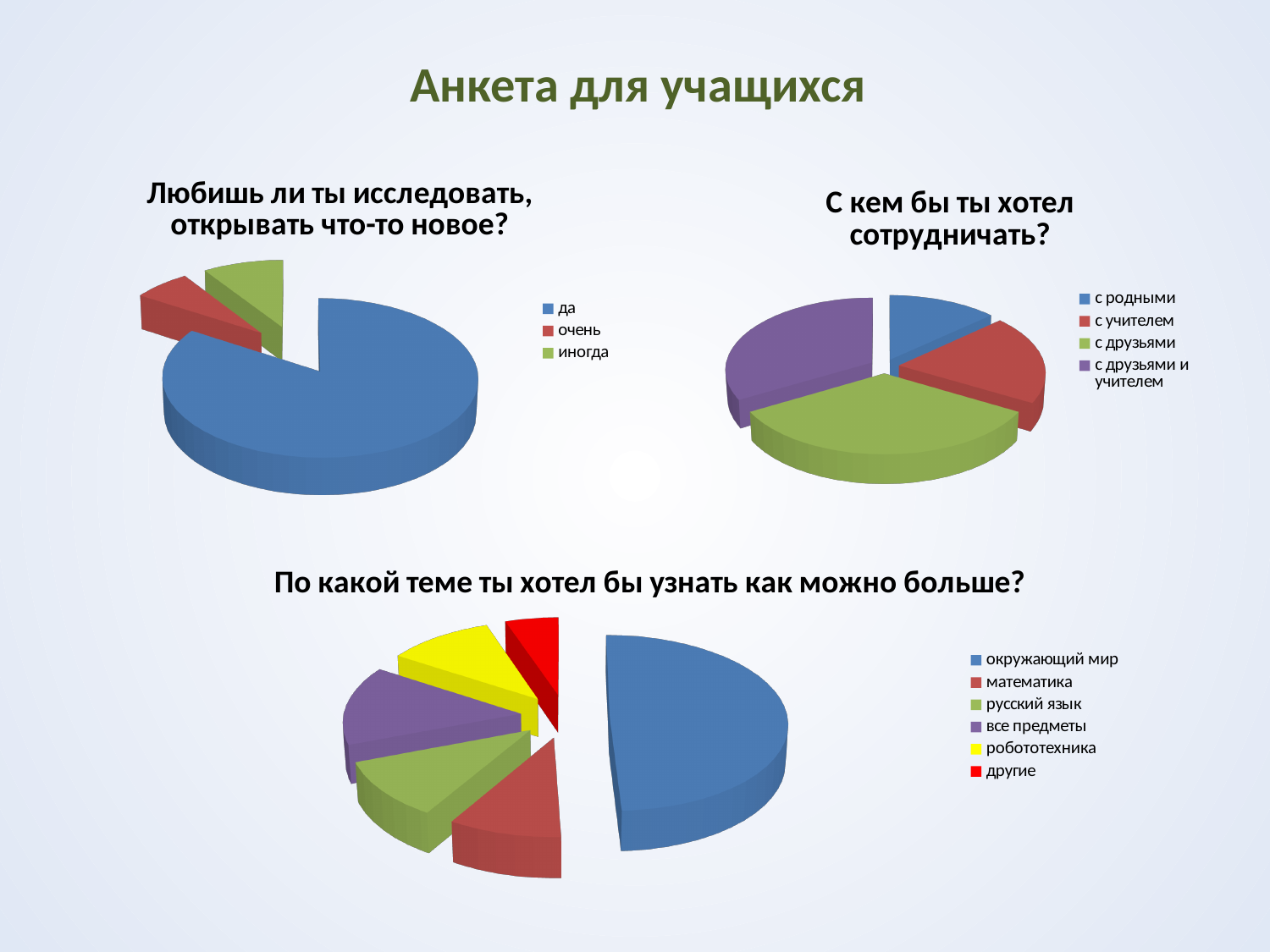
In the chart "С кем бы ты хотел сотрудничать?", which slice is larger: "с друзьями" or "с родными"? с друзьями How many categories does the legend of "Любишь ли ты исследовать, открывать что-то новое?" list? 3 How many charts are shown on the slide? 3 In the chart "По какой теме ты хотел бы узнать как можно больше?", what colour is the slice for "робототехника"? yellow In the chart "По какой теме ты хотел бы узнать как можно больше?", which topic has the largest slice? окружающий мир What kind of chart is used for "Любишь ли ты исследовать, открывать что-то новое?"? pie chart In the chart "По какой теме ты хотел бы узнать как можно больше?", which topic has the smallest slice? другие In the chart "Любишь ли ты исследовать, открывать что-то новое?", which answer has the largest slice? да In the chart "По какой теме ты хотел бы узнать как можно больше?", which slice is larger: "окружающий мир" or "математика"? окружающий мир How many categories does the legend of "По какой теме ты хотел бы узнать как можно больше?" list? 6 How many categories does the legend of "С кем бы ты хотел сотрудничать?" list? 4